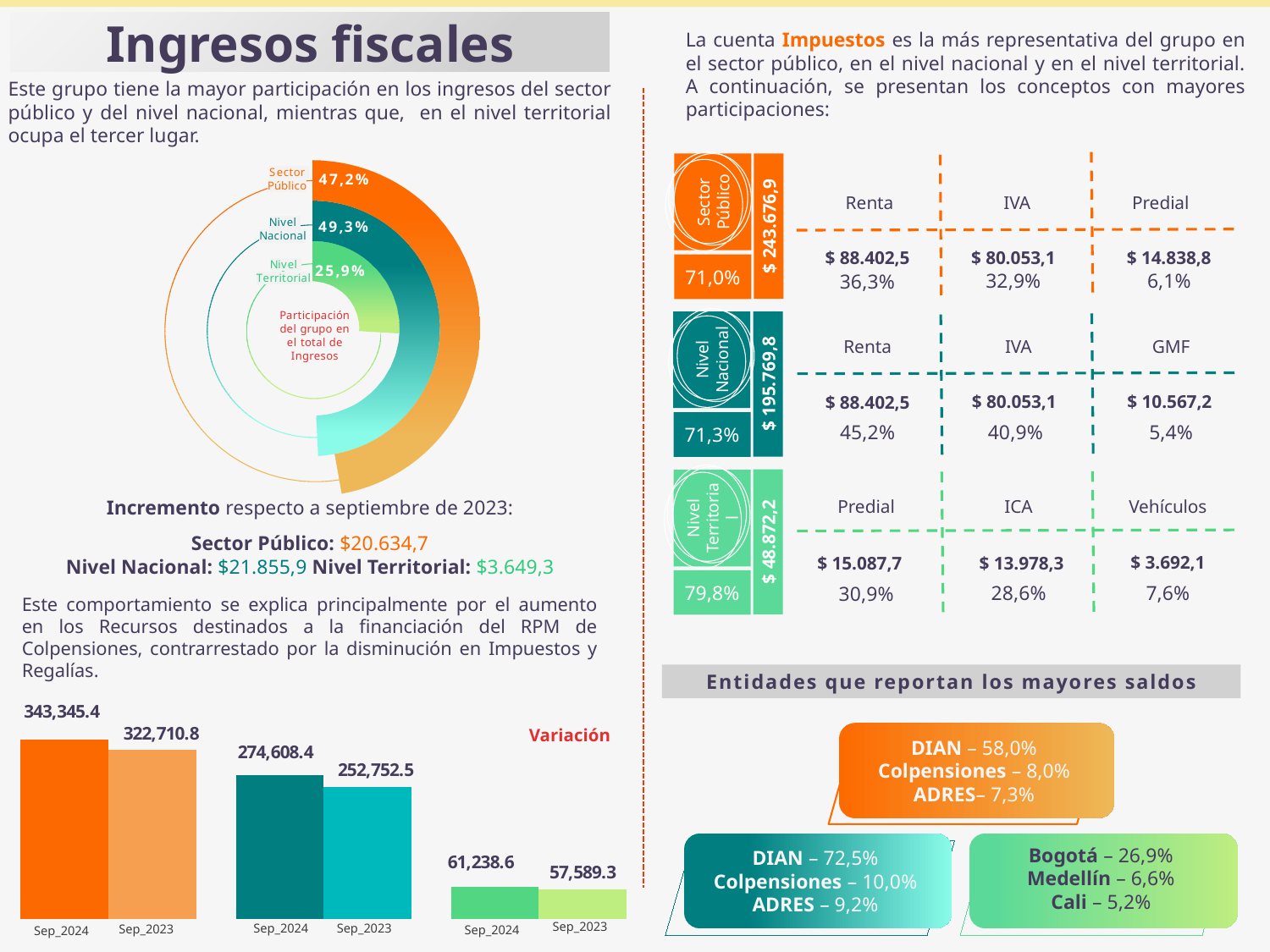
In the radial chart labelled 'Participación del grupo en el total de Ingresos', which level has the lowest participation? Nivel Territorial What kind of chart is shown at the bottom left of the slide? Bar chart In the bar chart at the bottom left, what is the difference between the Sep_2024 and Sep_2023 values for the teal (Nivel Nacional) bars? 21,855.9 In the radial chart labelled 'Participación del grupo en el total de Ingresos', what is the value for Nivel Territorial? 25,9% In the bar chart at the bottom left, what is the difference between the Sep_2024 and Sep_2023 values for the green (Nivel Territorial) bars? 3,649.3 In the radial chart labelled 'Participación del grupo en el total de Ingresos', which level has the highest participation? Nivel Nacional In the bar chart at the bottom left, what is the Sep_2024 value for the orange (Sector Público) bars? 343,345.4 In the bar chart at the bottom left, what is the Sep_2023 value for the teal (Nivel Nacional) bars? 252,752.5 In the radial chart labelled 'Participación del grupo en el total de Ingresos', what is the value for Sector Público? 47,2% In the radial chart labelled 'Participación del grupo en el total de Ingresos', how many levels are shown? 3 In the bar chart at the bottom left, what is the Sep_2024 value for the green (Nivel Territorial) bars? 61,238.6 In the bar chart at the bottom left, which is larger for the orange (Sector Público) bars: Sep_2024 or Sep_2023? Sep_2024